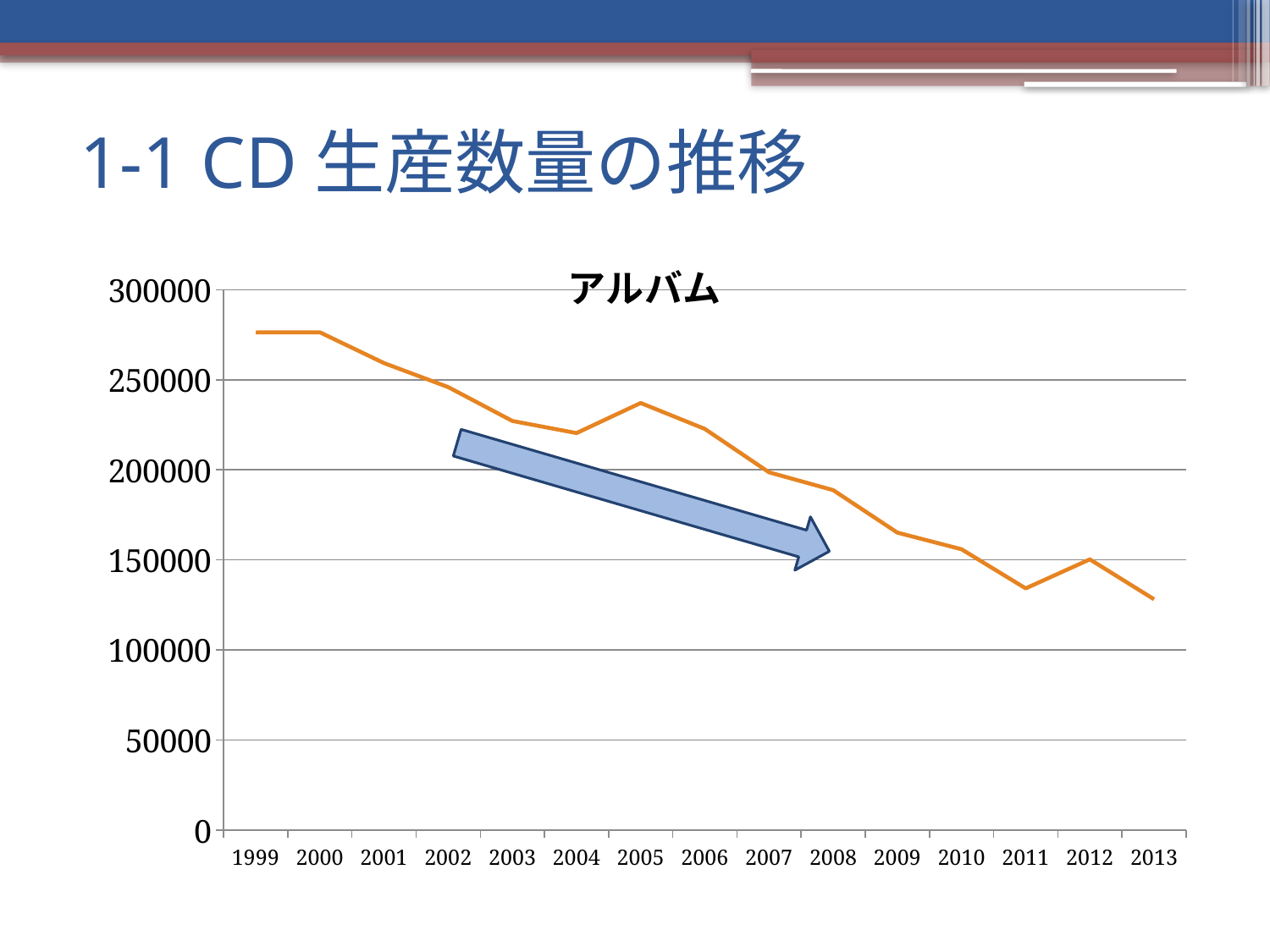
Is the value for 2009 greater or less than 150000? greater What kind of chart is shown on the slide? line chart Is the value for 1999 greater or less than 250000? greater What is the title of the chart? アルバム What colour is the plotted line? orange Is the value for 2011 greater or less than 150000? less Which year has the larger value, 2011 or 2012? 2012 Which year has the larger value, 2004 or 2005? 2005 How many years are plotted along the x axis? 15 Do the values generally rise or fall from 1999 to 2013? fall